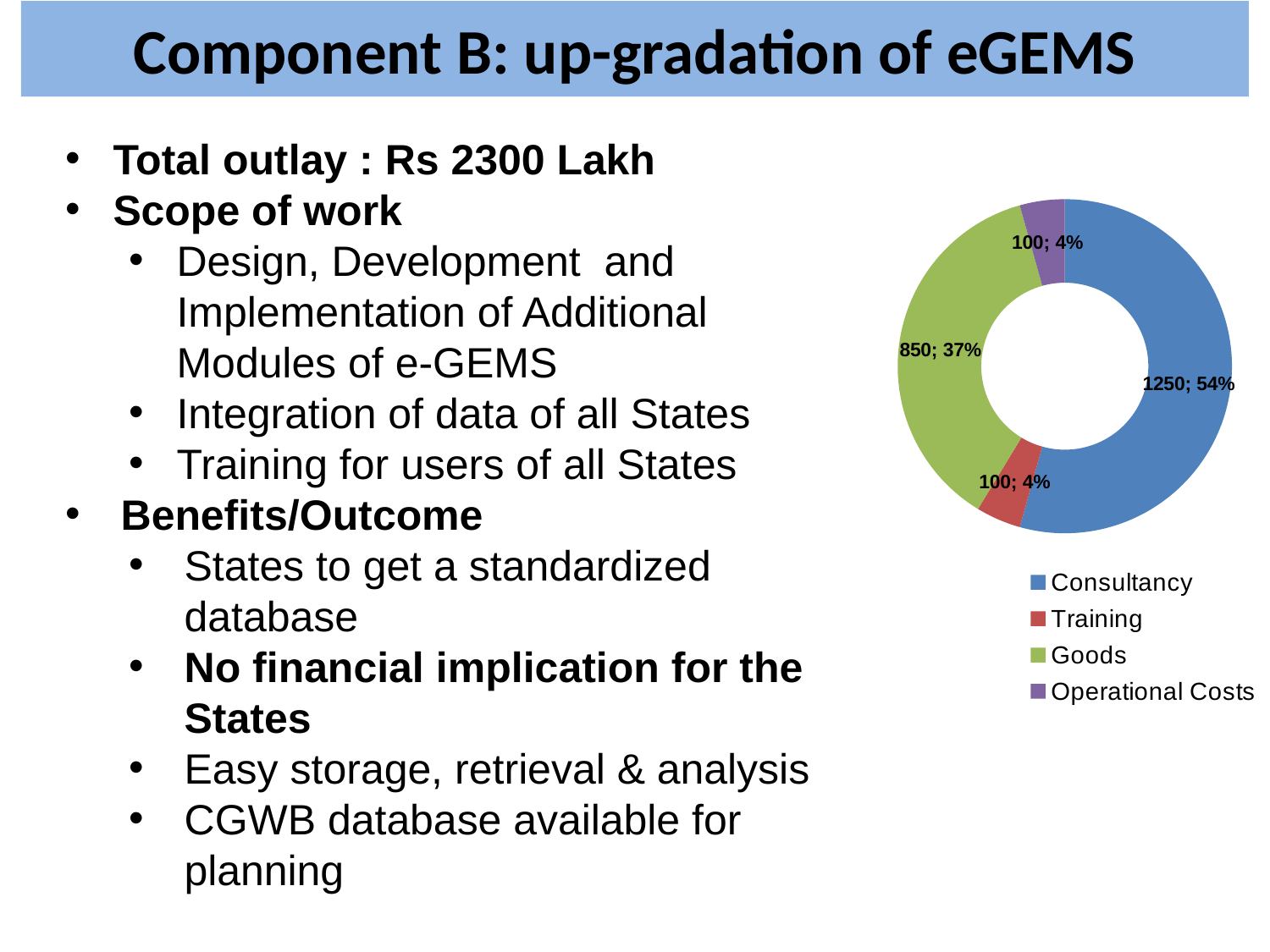
What value is shown for Consultancy in the chart? 1250 What percentage share does Consultancy have in the chart? 54% Which category has the largest slice in the chart? Consultancy What kind of chart is shown on the slide? Doughnut (pie) chart What is the difference between the values for Consultancy and Goods? 400 What value is shown for Training in the chart? 100 What percentage share does Operational Costs have in the chart? 4% Which is larger, the value for Goods or the value for Training? Goods What percentage share does Goods have in the chart? 37% What colour represents Goods in the chart? Green What value is shown for Goods in the chart? 850 How many categories are shown in the chart? 4